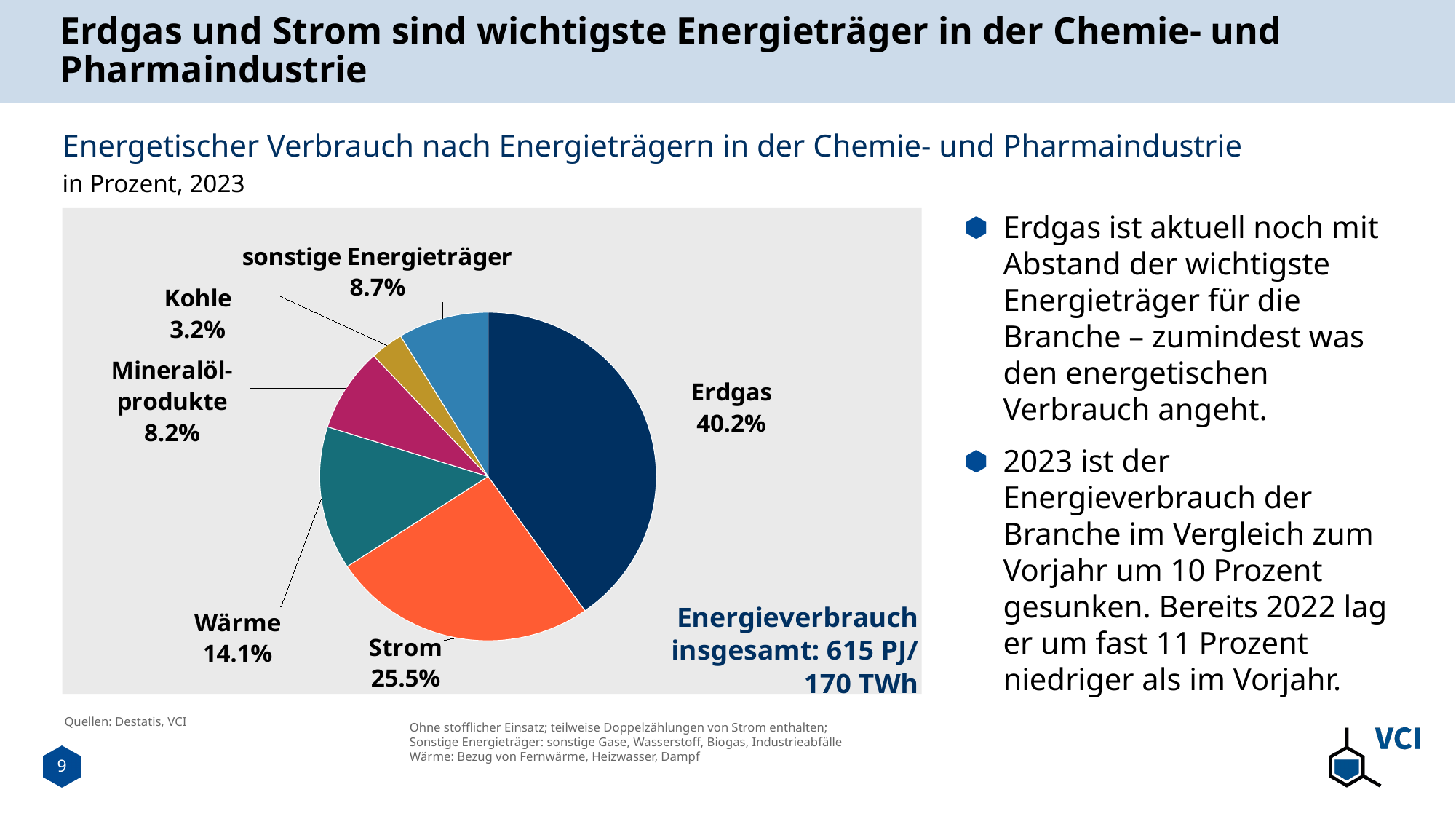
How many categories are shown in the pie chart? 6 Which energy source has the largest slice of the pie chart? Erdgas What type of chart is shown on the slide? Pie chart What is the value shown for Strom in the pie chart? 25.5% What is the value for Kohle in the pie chart? 3.2% Which is larger, the share for Mineralölprodukte or the share for sonstige Energieträger? sonstige Energieträger What total energy consumption is stated next to the pie chart? 615 PJ/170 TWh What share of energy consumption does Erdgas account for in the pie chart? 40.2% What year does the chart refer to? 2023 What percentage is shown for Wärme? 14.1% What is the difference in percentage points between Erdgas and Strom? 14.7 Which energy source has the smallest slice of the pie chart? Kohle